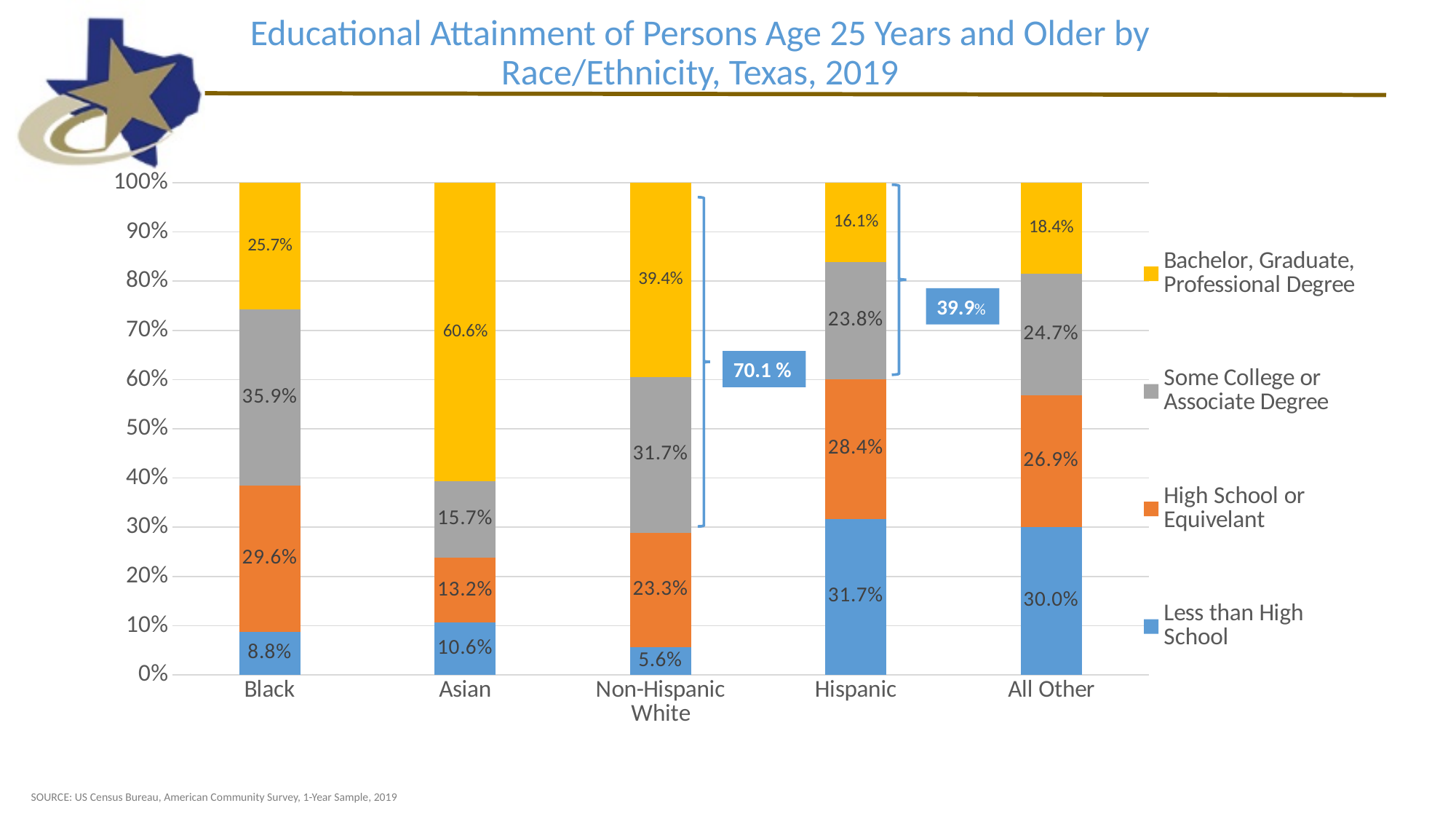
Which race/ethnicity category has the lowest Less than High School share? Non-Hispanic White How many education levels does the legend list? 4 What is the difference between the Bachelor, Graduate, Professional Degree values for Non-Hispanic White and Hispanic? 23.3 percentage points What kind of chart is shown on the slide? Stacked bar chart Which race/ethnicity category has the highest share with a Bachelor, Graduate, or Professional Degree? Asian Which education level is the largest segment of the Black bar? Some College or Associate Degree How many race/ethnicity categories are shown on the x axis? 5 What is the Some College or Associate Degree value for the All Other category? 24.7% Which has a larger High School or Equivelant share, Hispanic or All Other? Hispanic What is the difference between the Some College or Associate Degree values for Black (35.9%) and Asian (15.7%)? 20.2 percentage points What is the Less than High School value for Hispanic persons? 31.7% What percentage of Asian persons age 25 and older have a Bachelor, Graduate, or Professional Degree? 60.6%